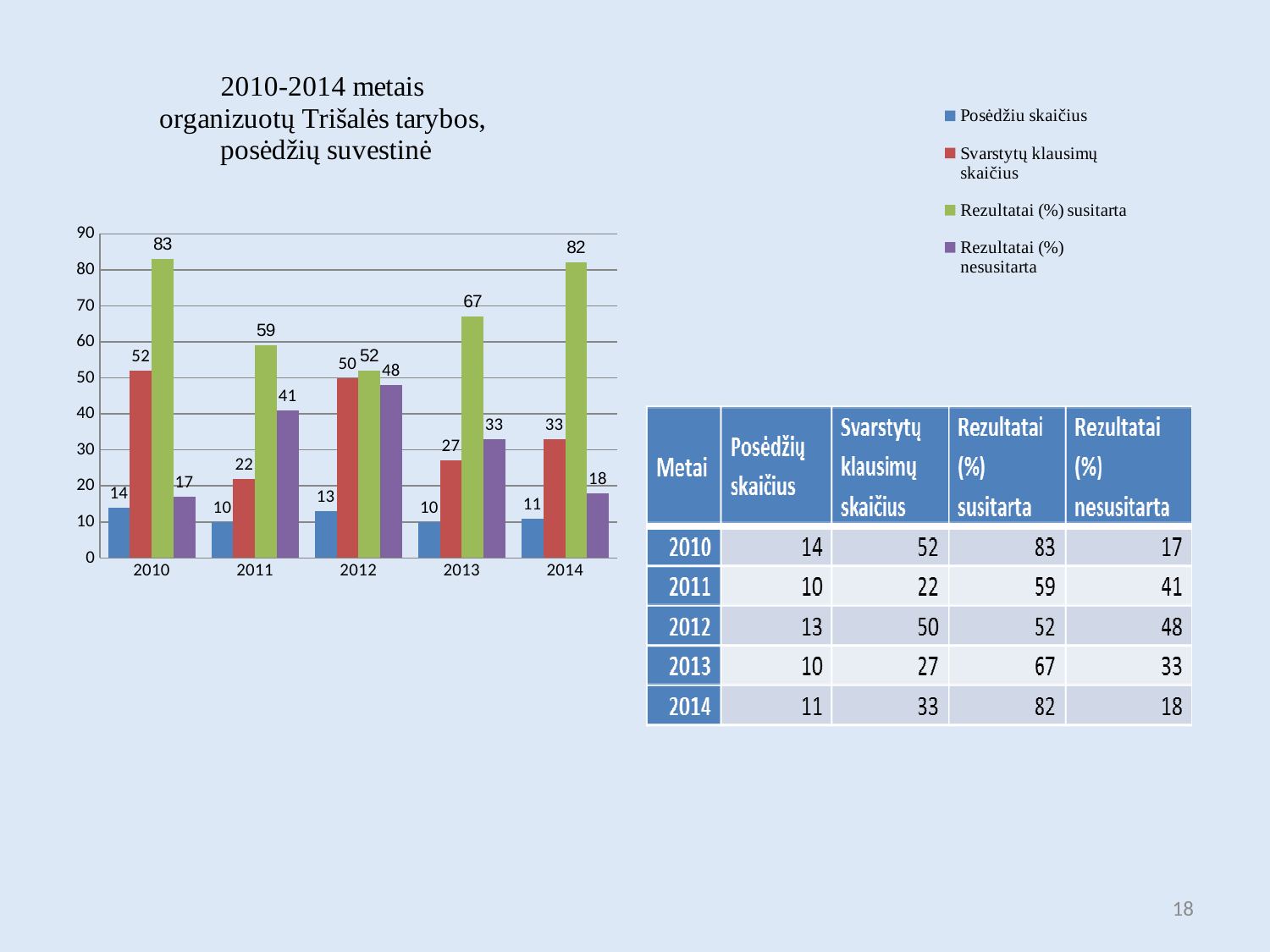
What colour are the bars for Rezultatai (%) susitarta? green What is the value of Rezultatai (%) nesusitarta for 2011? 41 Which year has the highest value for Rezultatai (%) susitarta? 2010 What is the difference between Rezultatai (%) susitarta and Rezultatai (%) nesusitarta in 2013? 34 Is the value of Rezultatai (%) susitarta for 2014 greater or less than 70? greater Which year has the lowest value for Svarstytų klausimų skaičius? 2011 What is the value of Svarstytų klausimų skaičius for 2012? 50 What is the value of Posėdžiu skaičius for 2010? 14 Which is larger in 2012: Svarstytų klausimų skaičius or Rezultatai (%) nesusitarta? Svarstytų klausimų skaičius How many years are shown on the x axis of the chart? 5 What kind of chart is shown on the slide? bar chart How many series does the chart legend list? 4